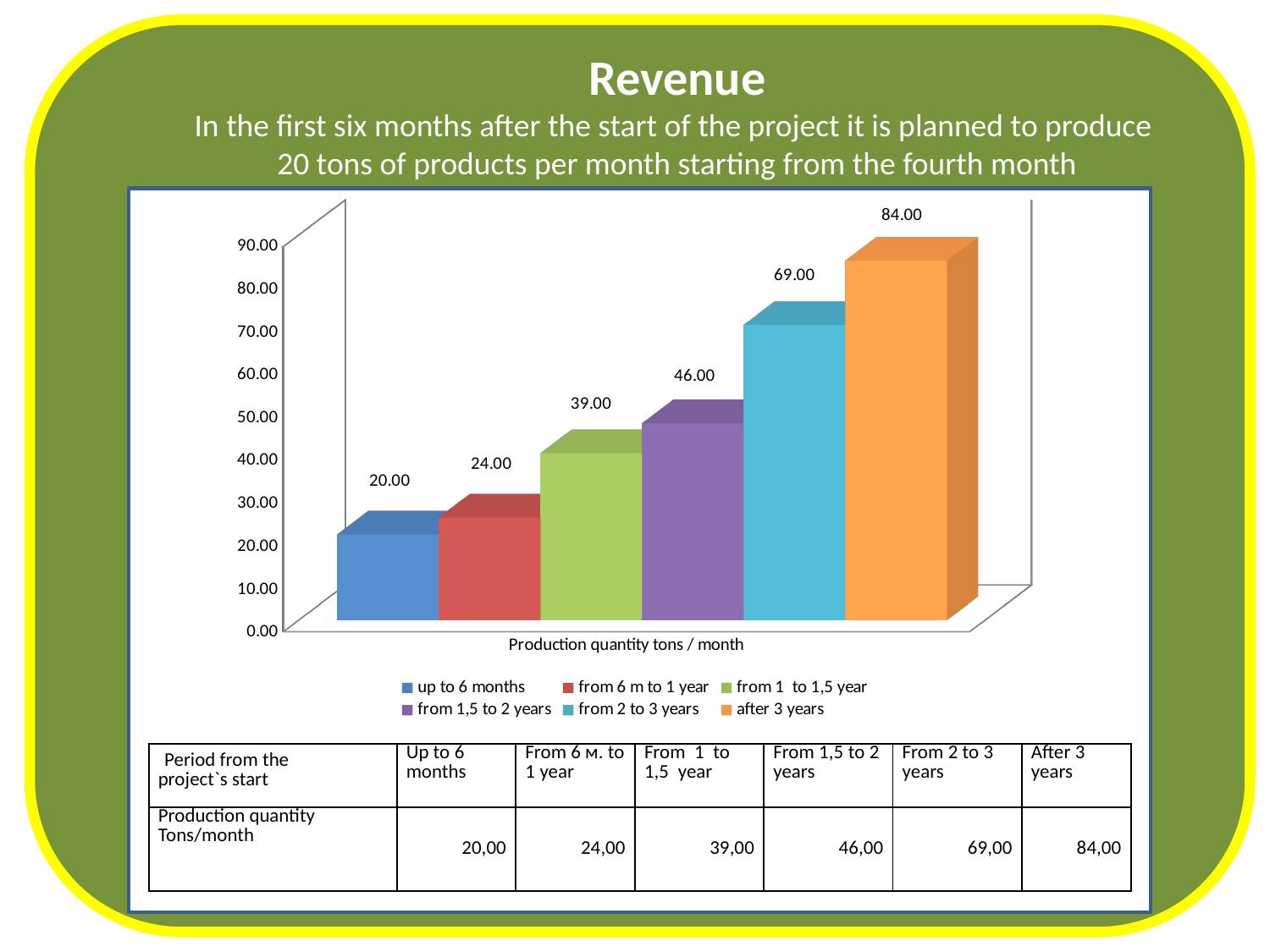
Do the values rise or fall from the 'up to 6 months' bar to the 'after 3 years' bar? rise Which series has the highest production quantity? after 3 years Which is larger: the value for 'from 6 m to 1 year' or the value for 'from 1 to 1,5 year'? from 1 to 1,5 year What is the difference between the 'from 2 to 3 years' value and the 'from 1,5 to 2 years' value? 23.00 What is the production quantity for the 'up to 6 months' series? 20.00 How many series does the legend list? 6 What is the label on the horizontal axis of the chart? Production quantity tons / month What kind of chart is shown on the slide? bar chart What colour is the bar for the 'after 3 years' series? orange Which series has the lowest production quantity? up to 6 months What is the production quantity for the 'from 1 to 1,5 year' series? 39.00 What is the production quantity for the 'after 3 years' series? 84.00